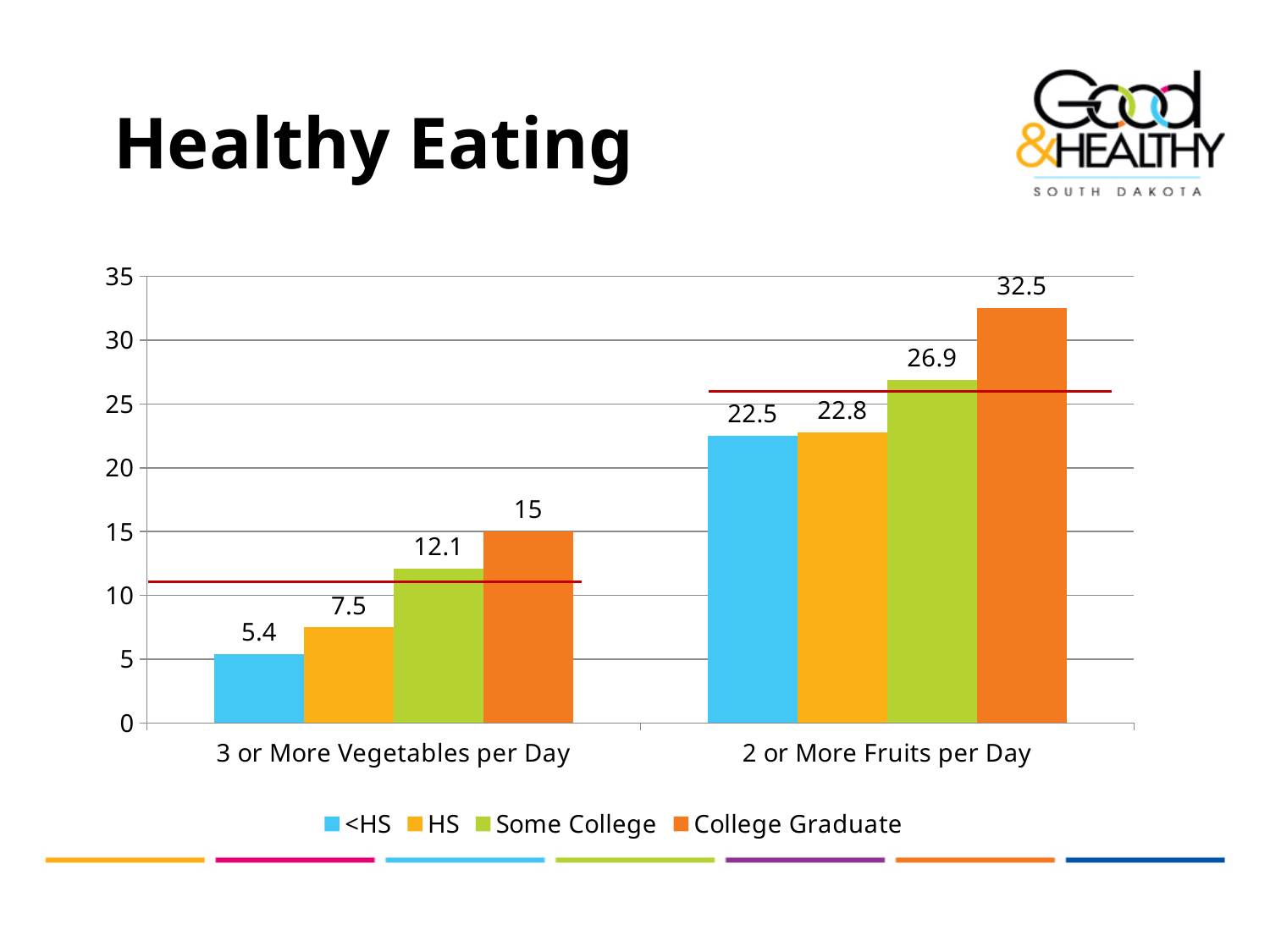
What is the value for Some College in the '3 or More Vegetables per Day' category? 12.1 What is the value for College Graduate in the '3 or More Vegetables per Day' category? 15 What kind of chart is shown on the slide? Bar chart Which series has the highest value in the '2 or More Fruits per Day' category? College Graduate What is the difference between the HS and <HS values in the '3 or More Vegetables per Day' category? 2.1 Is the value for Some College in the '2 or More Fruits per Day' category greater or less than 25? greater Which series has the lowest value in the '3 or More Vegetables per Day' category? <HS What is the value for <HS in the '2 or More Fruits per Day' category? 22.5 How many categories are shown on the x axis? 2 What is the difference between the College Graduate and <HS values in the '2 or More Fruits per Day' category? 10 How many series does the legend list? 4 Which is larger: the Some College value for '3 or More Vegetables per Day' or the HS value for '3 or More Vegetables per Day'? Some College